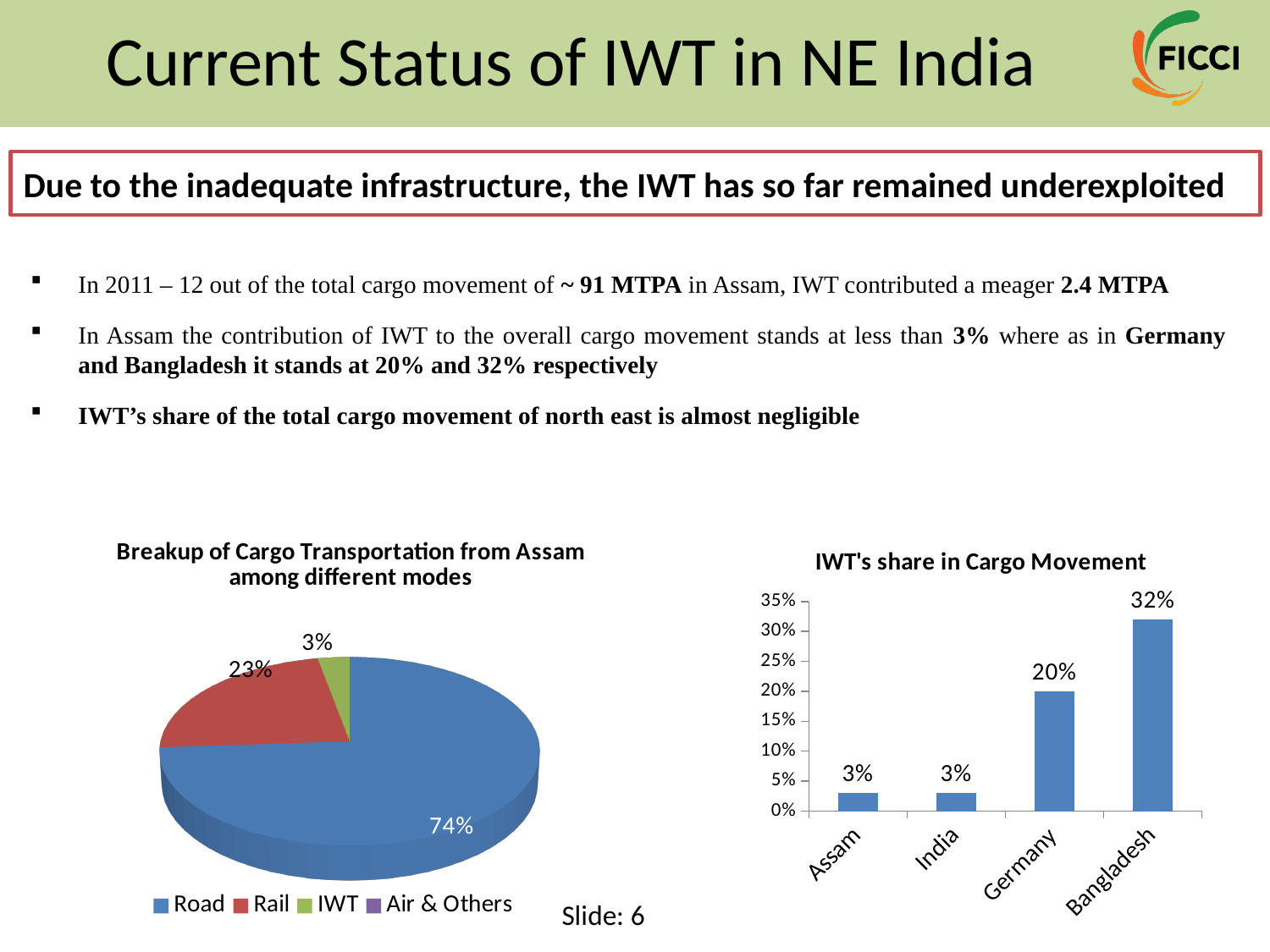
How many entries does the legend of the 'Breakup of Cargo Transportation from Assam among different modes' chart list? 4 In the 'IWT's share in Cargo Movement' chart, how many categories are shown on the x axis? 4 In the 'Breakup of Cargo Transportation from Assam among different modes' chart, which mode has the largest slice? Road In the 'IWT's share in Cargo Movement' chart, which is larger, the value for Germany or the value for India? Germany What kind of chart is 'IWT's share in Cargo Movement'? Bar chart In the 'Breakup of Cargo Transportation from Assam among different modes' chart, what share does Rail have? 23% In the 'IWT's share in Cargo Movement' chart, what is the value for Bangladesh? 32% In the 'IWT's share in Cargo Movement' chart, what is the value for Germany? 20% In the 'IWT's share in Cargo Movement' chart, what is the difference between the values for Bangladesh and Germany? 12% What kind of chart is 'Breakup of Cargo Transportation from Assam among different modes'? Pie chart In the 'IWT's share in Cargo Movement' chart, which category has the highest value? Bangladesh In the 'Breakup of Cargo Transportation from Assam among different modes' chart, what share does Road have? 74%